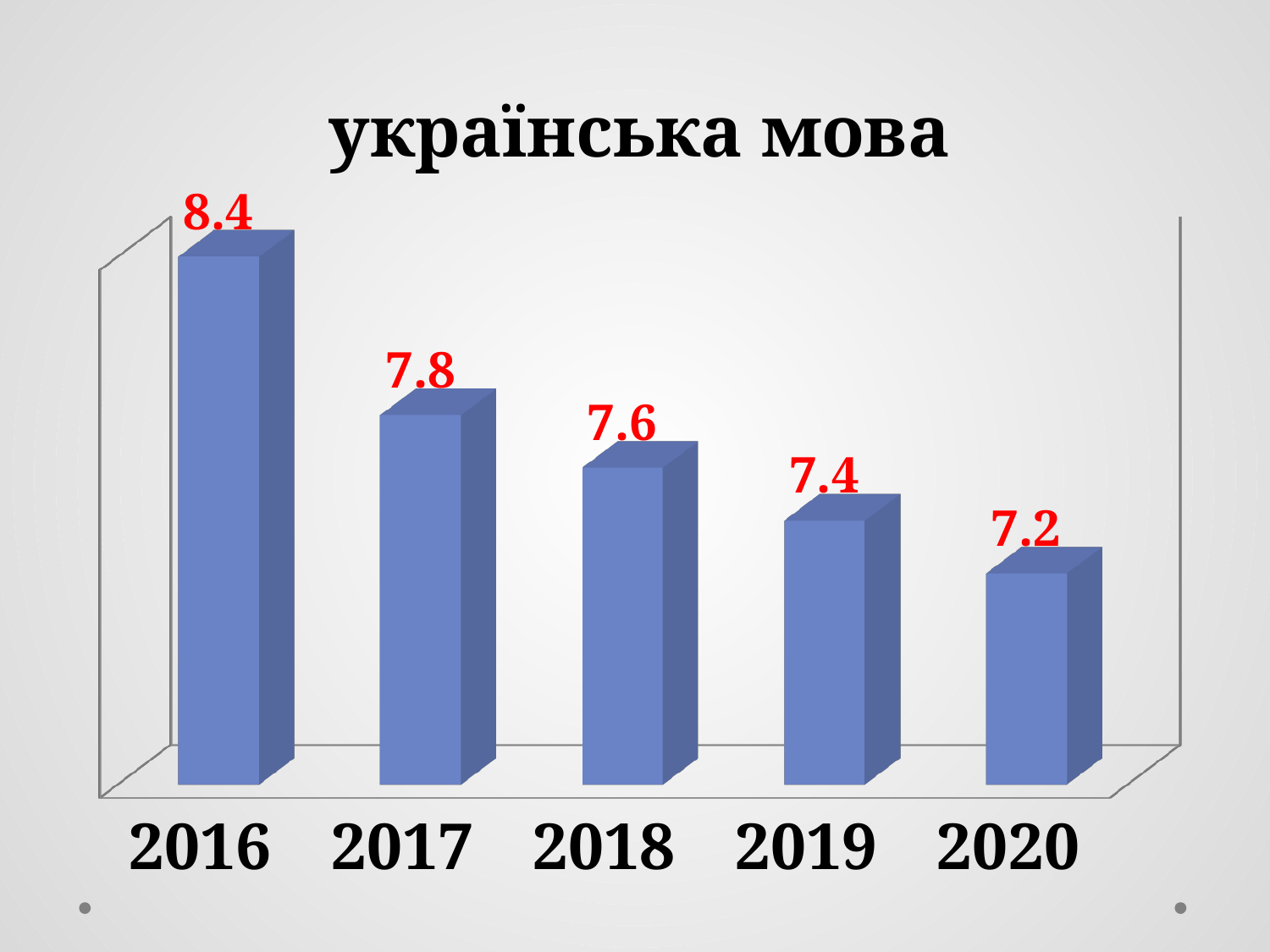
How many years are shown on the chart? 5 What kind of chart is this? bar chart What is the title of the chart? українська мова What is the difference between the values for 2019 and 2020? 0.2 Which is larger, the value for 2017 or the value for 2019? 2017 What is the value for 2016? 8.4 What is the difference between the values for 2016 and 2017? 0.6 Which year has the lowest value? 2020 What is the value for 2018? 7.6 Do the values rise or fall from 2016 to 2020? fall What is the value for 2020? 7.2 Which year has the highest value? 2016